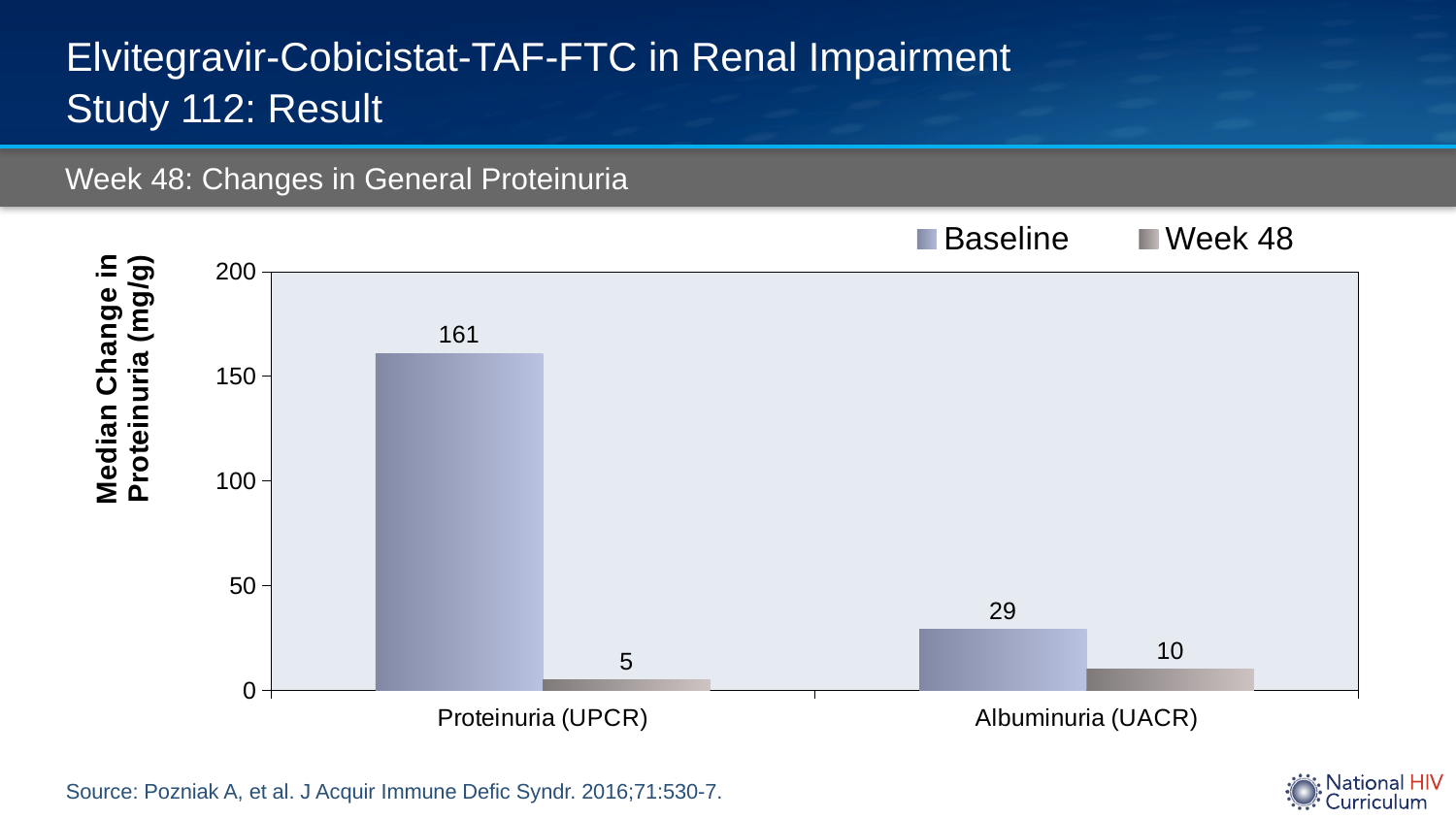
What kind of chart is shown on the slide? Bar chart Which category has the highest Baseline value? Proteinuria (UPCR) What is the difference between the Baseline and Week 48 values for Proteinuria (UPCR)? 156 How many categories are shown on the x axis? 2 What is the Baseline value for Albuminuria (UACR)? 29 What is the Week 48 value for Albuminuria (UACR)? 10 What is the Baseline value for Proteinuria (UPCR)? 161 What is the difference between the Baseline and Week 48 values for Albuminuria (UACR)? 19 What is the Week 48 value for Proteinuria (UPCR)? 5 How many series does the legend list? 2 Which category has the lowest Week 48 value? Proteinuria (UPCR) Which is larger: the Week 48 value for Proteinuria (UPCR) or the Week 48 value for Albuminuria (UACR)? Albuminuria (UACR)